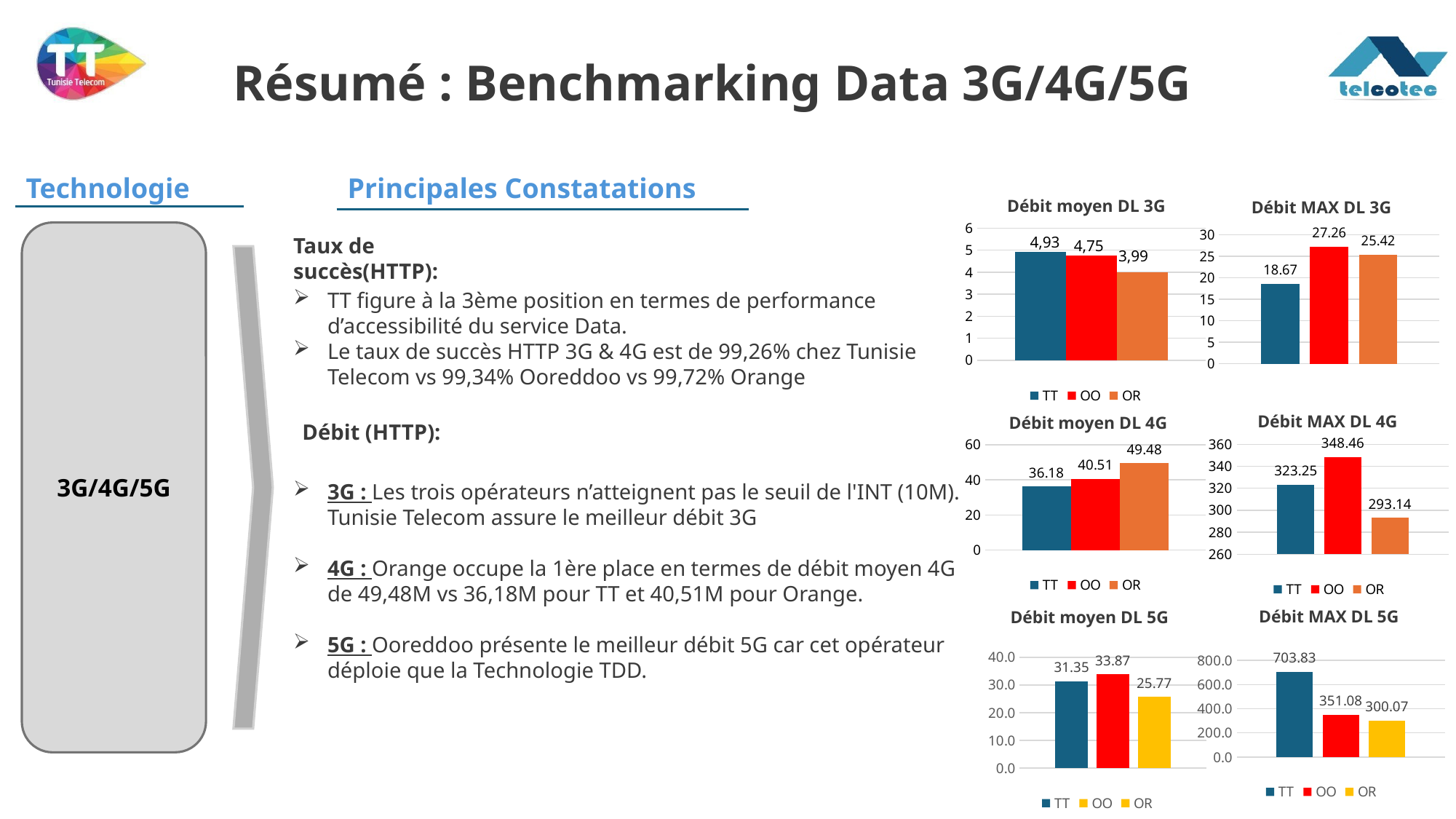
In the 'Débit MAX DL 5G' chart, what is the difference between the TT value and the OO value? 352.75 In the 'Débit MAX DL 3G' chart, which operator has the highest value? OO In the 'Débit MAX DL 4G' chart, what is the value for OR? 293.14 How many series does the legend of the 'Débit MAX DL 4G' chart list? 3 How many bars are plotted in the 'Débit moyen DL 3G' chart? 3 In the 'Débit MAX DL 5G' chart, what is the value for TT? 703.83 What kind of chart is the 'Débit moyen DL 5G' chart? bar chart In the 'Débit moyen DL 3G' chart, what is the difference between the TT value and the OR value? 0,94 In the 'Débit MAX DL 4G' chart, which operator has the lowest value? OR In the 'Débit moyen DL 4G' chart, what is the difference between the OR value and the TT value? 13.30 In the 'Débit moyen DL 5G' chart, which is larger, the value for TT or the value for OO? OO In the 'Débit moyen DL 3G' chart, what is the value for TT? 4,93